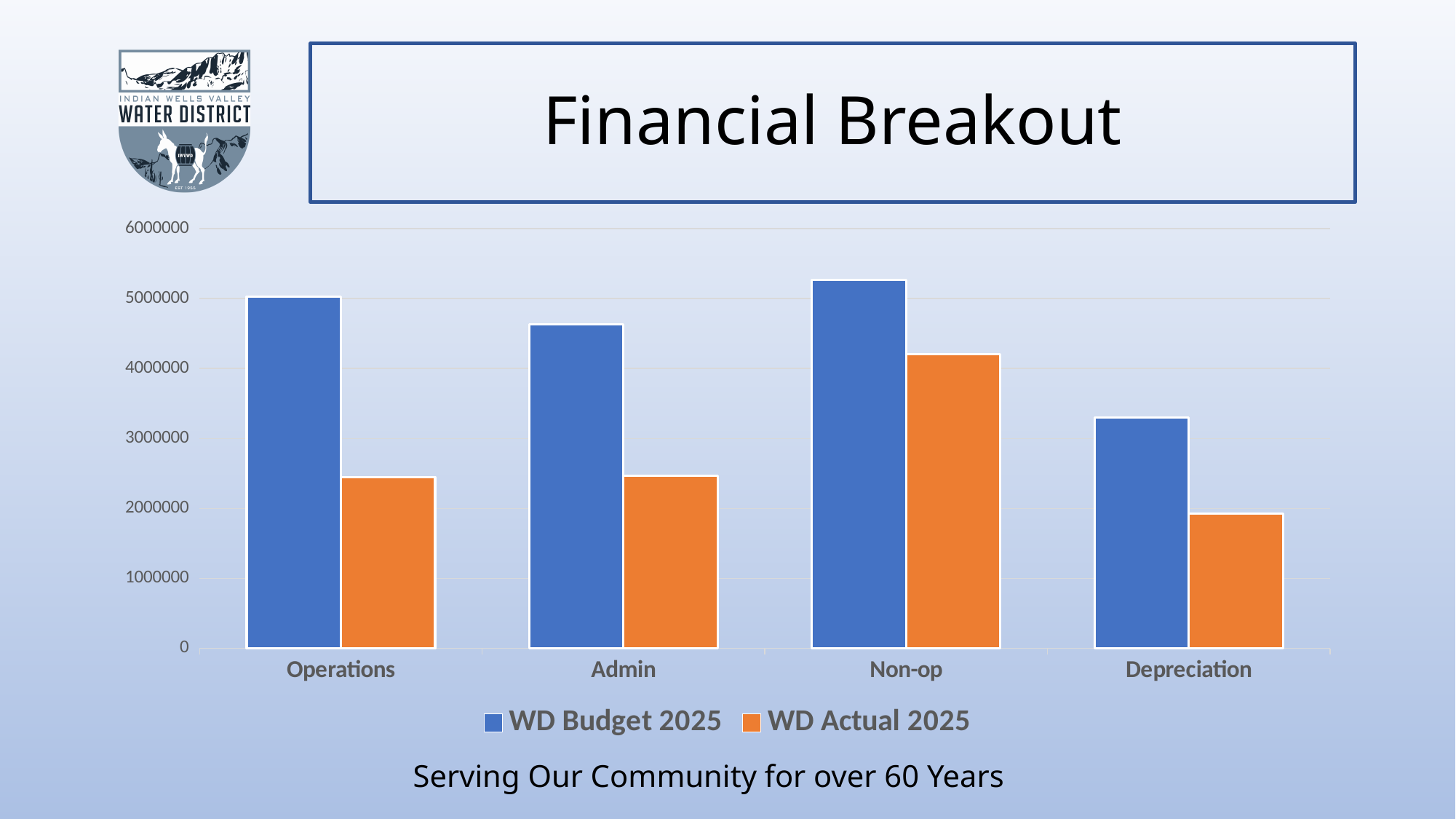
Is the WD Actual 2025 value for Operations greater or less than 3000000? less Which category has the highest WD Budget 2025 value? Non-op How many series does the chart's legend list? 2 Which category has the lowest WD Actual 2025 value? Depreciation Which is larger, the WD Budget 2025 value for Operations or for Admin? Operations Which category has the highest WD Actual 2025 value? Non-op Which category has the lowest WD Budget 2025 value? Depreciation How many categories are shown on the x axis of the chart? 4 What colour are the WD Actual 2025 bars in the chart? orange Is the WD Budget 2025 value for Non-op greater or less than 5000000? greater What kind of chart is shown on the slide? bar chart Is the WD Budget 2025 value for Admin greater or less than 4000000? greater